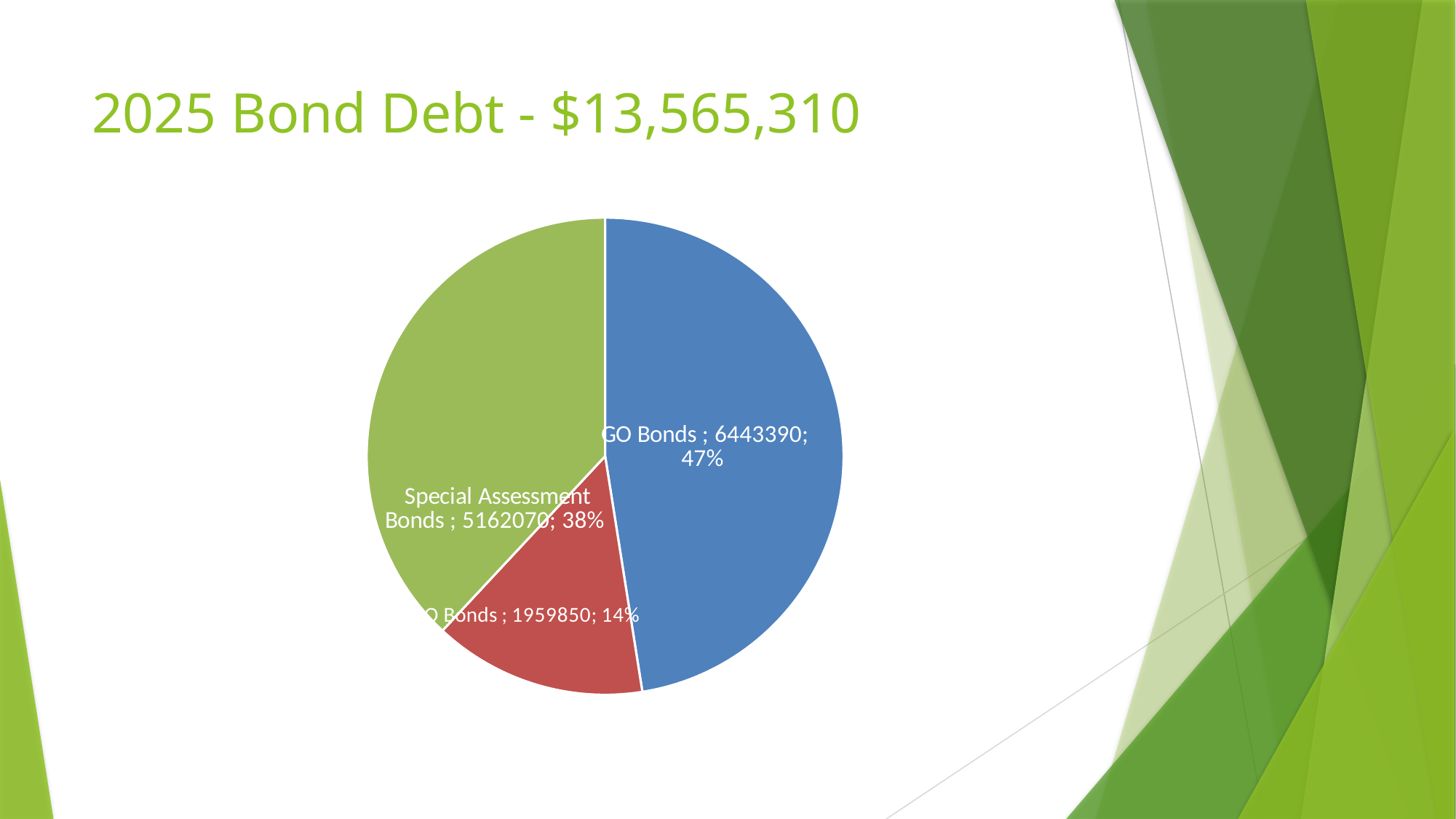
What share of the pie does the red slice represent? 14% What is the value shown for GO Bonds? 6443390 Which category has the largest slice of the pie? GO Bonds What is the value shown for the red slice of the pie? 1959850 What share of the pie do Special Assessment Bonds represent? 38% What share of the pie do GO Bonds represent? 47% Which colour slice is the smallest in the pie? Red Which is larger, GO Bonds or Special Assessment Bonds? GO Bonds What is the title of the slide? 2025 Bond Debt - $13,565,310 What is the difference between the GO Bonds value and the Special Assessment Bonds value? 1281320 How many slices does the pie chart have? 3 What is the value shown for Special Assessment Bonds? 5162070